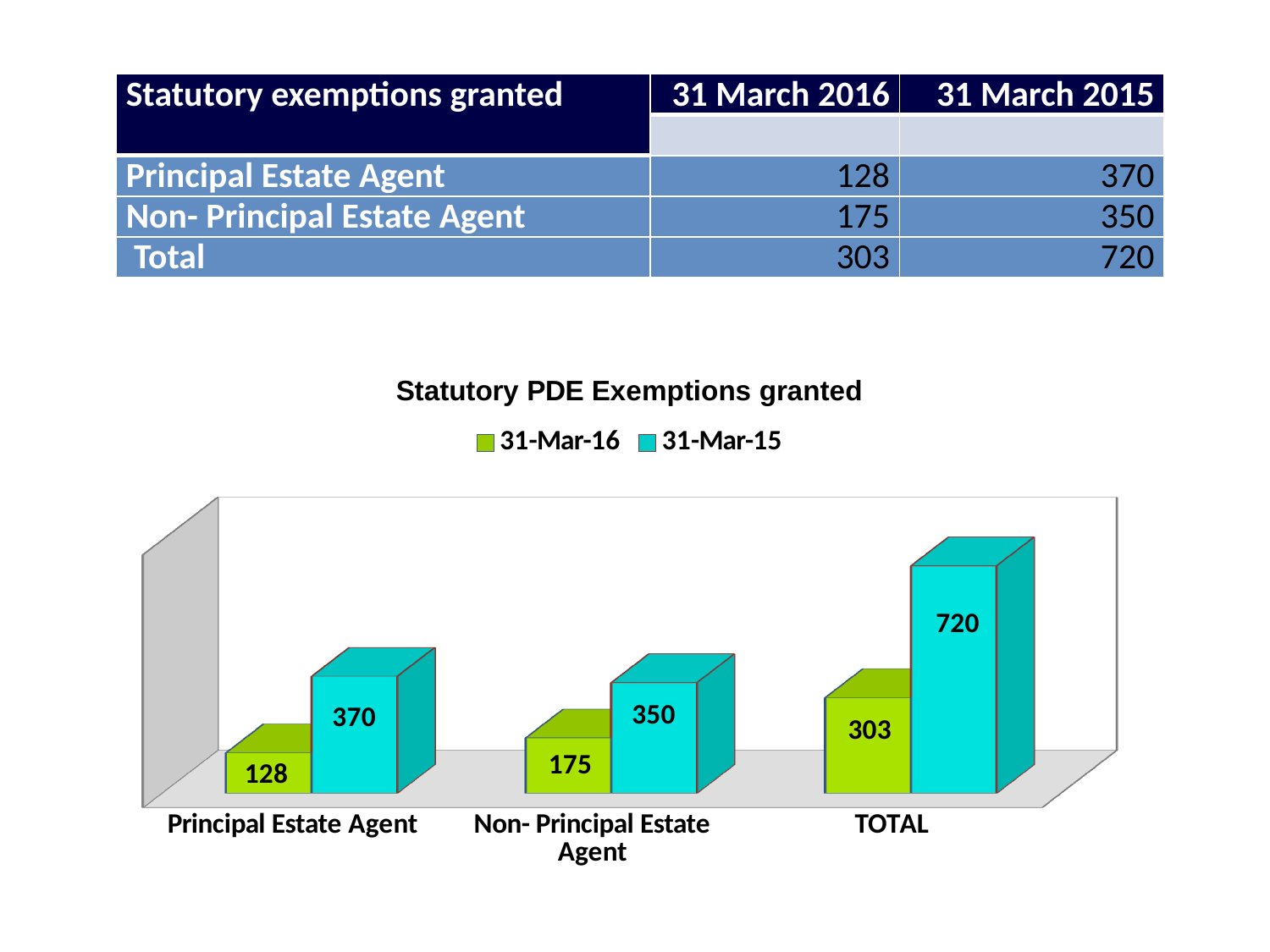
Which category has the lowest value in the 31-Mar-15 series? Non- Principal Estate Agent What is the value for TOTAL in the 31-Mar-15 series? 720 What is the title of the chart? Statutory PDE Exemptions granted What is the value for Principal Estate Agent in the 31-Mar-16 series? 128 Which is larger for Non- Principal Estate Agent: the 31-Mar-16 value or the 31-Mar-15 value? 31-Mar-15 What is the value for Non- Principal Estate Agent in the 31-Mar-15 series? 350 Which category has the highest value in the 31-Mar-16 series? TOTAL Which colour represents the 31-Mar-15 series? cyan How many series does the legend list? 2 What kind of chart is shown on the slide? bar chart How many categories are shown on the x axis? 3 What is the difference between the 31-Mar-15 and 31-Mar-16 values for Principal Estate Agent? 242